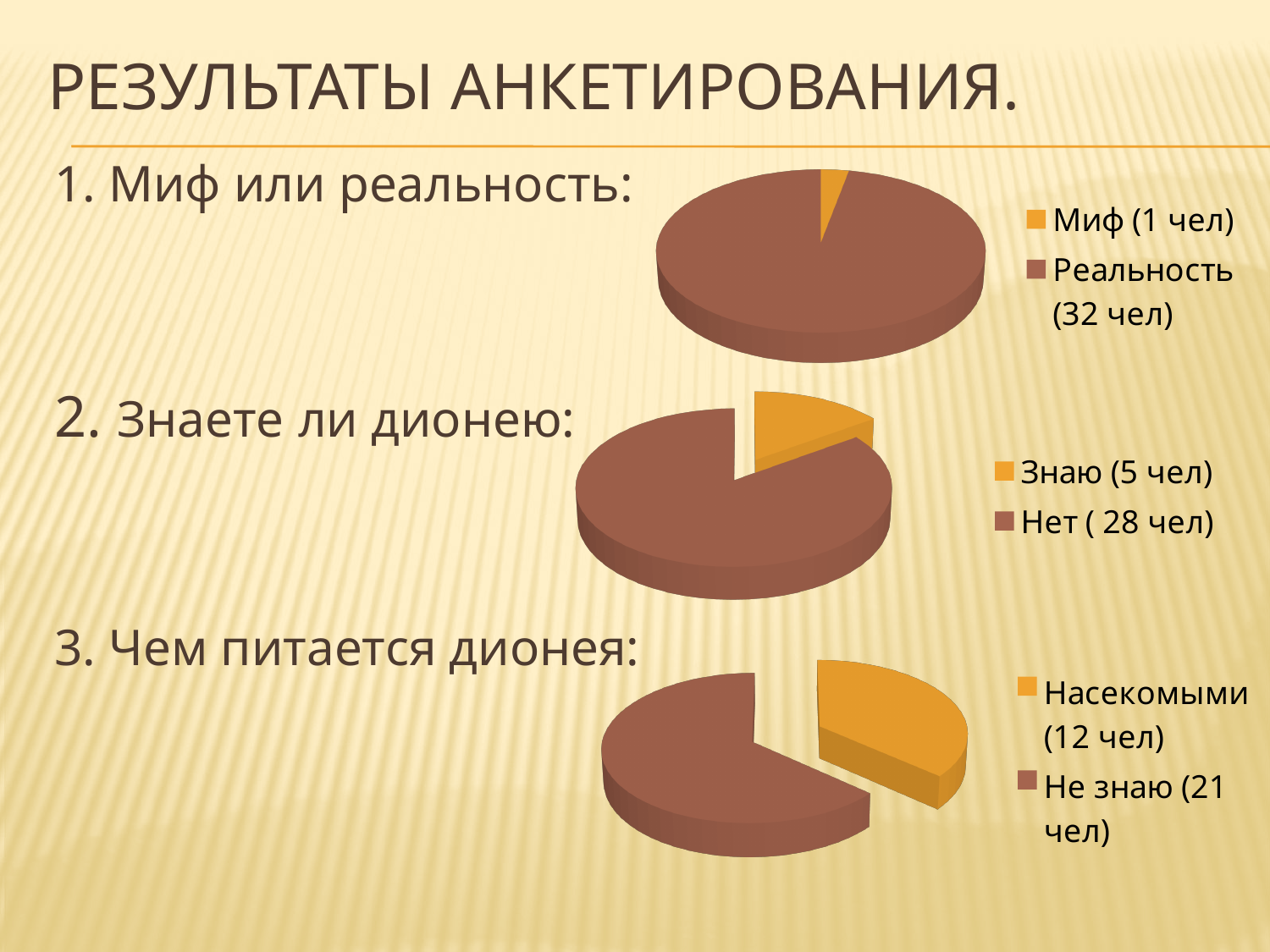
On the bottom pie chart ("Чем питается дионея"), how many people answered "Насекомыми"? 12 чел On the middle pie chart ("Знаете ли дионею"), how many people answered "Знаю"? 5 чел On the middle pie chart ("Знаете ли дионею"), how many people answered "Нет"? 28 чел What type of chart is used for the three charts on the slide? Pie chart On the bottom pie chart ("Чем питается дионея"), how many people answered "Не знаю"? 21 чел On the bottom pie chart ("Чем питается дионея"), what is the difference between "Не знаю" and "Насекомыми"? 9 How many entries does the legend of the middle pie chart ("Знаете ли дионею") list? 2 On the bottom pie chart ("Чем питается дионея"), which answer has the smallest slice? Насекомыми On the middle pie chart ("Знаете ли дионею"), how many more people answered "Нет" than "Знаю"? 23 On the top pie chart ("Миф или реальность"), how many people answered "Реальность"? 32 чел On the top pie chart ("Миф или реальность"), how many people answered "Миф"? 1 чел On the top pie chart ("Миф или реальность"), which answer has the largest slice? Реальность